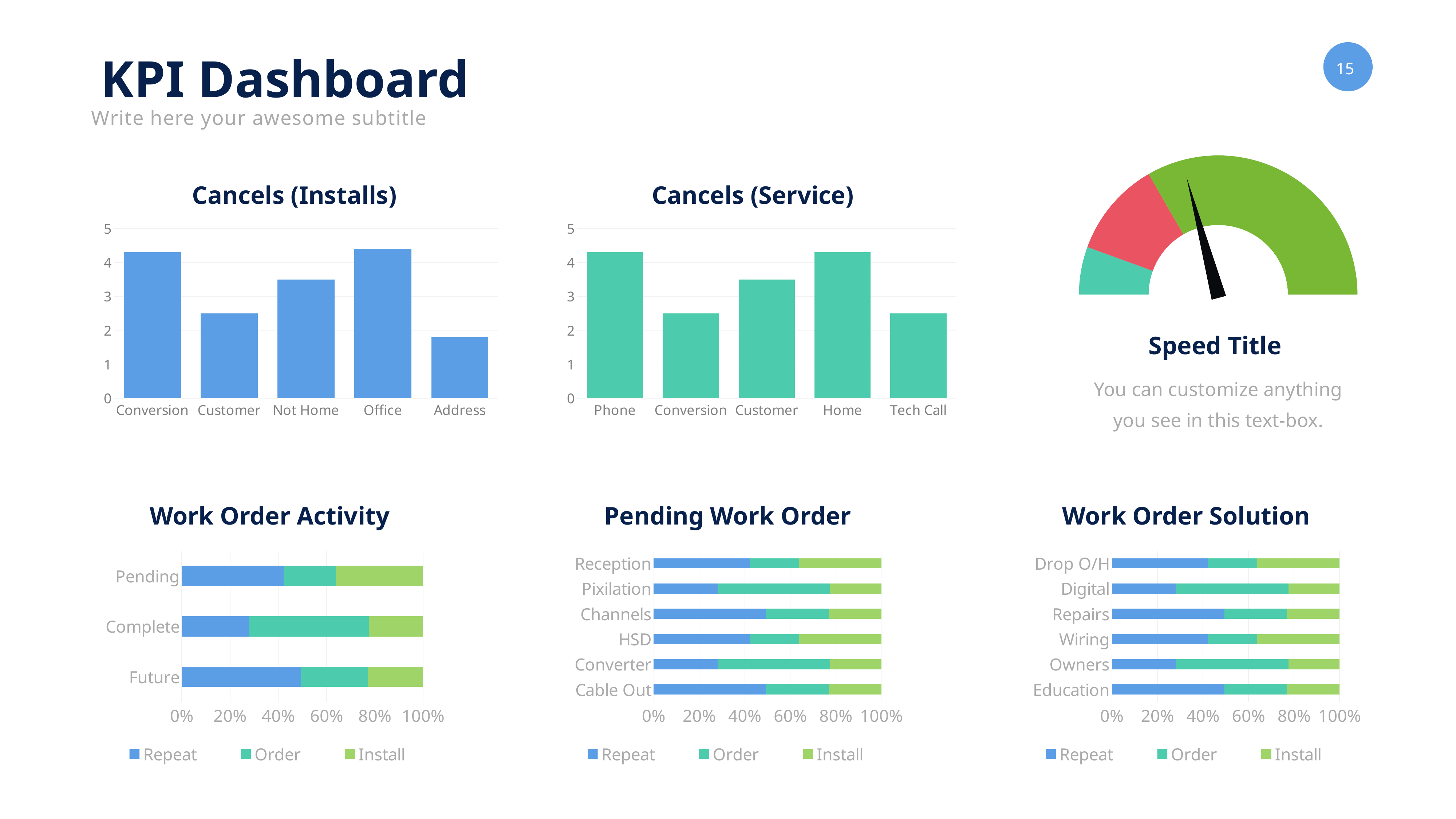
How many categories are shown in the Work Order Solution chart? 6 In the Cancels (Service) chart, which is larger, the value for Home or the value for Tech Call? Home How many series does the legend of the Pending Work Order chart list? 3 What kind of chart is the Cancels (Service) chart? Bar chart In the Cancels (Installs) chart, which is larger, the value for Not Home or the value for Customer? Not Home In the Cancels (Installs) chart, which category has the lowest value? Address In the Cancels (Service) chart, is the value for Customer greater or less than 3? greater In the Cancels (Service) chart, is the value for Conversion greater or less than 3? less What are the legend entries of the Work Order Activity chart? Repeat, Order, Install In the Cancels (Installs) chart, is the value for Customer greater or less than 3? less How many categories are shown in the Cancels (Installs) chart? 5